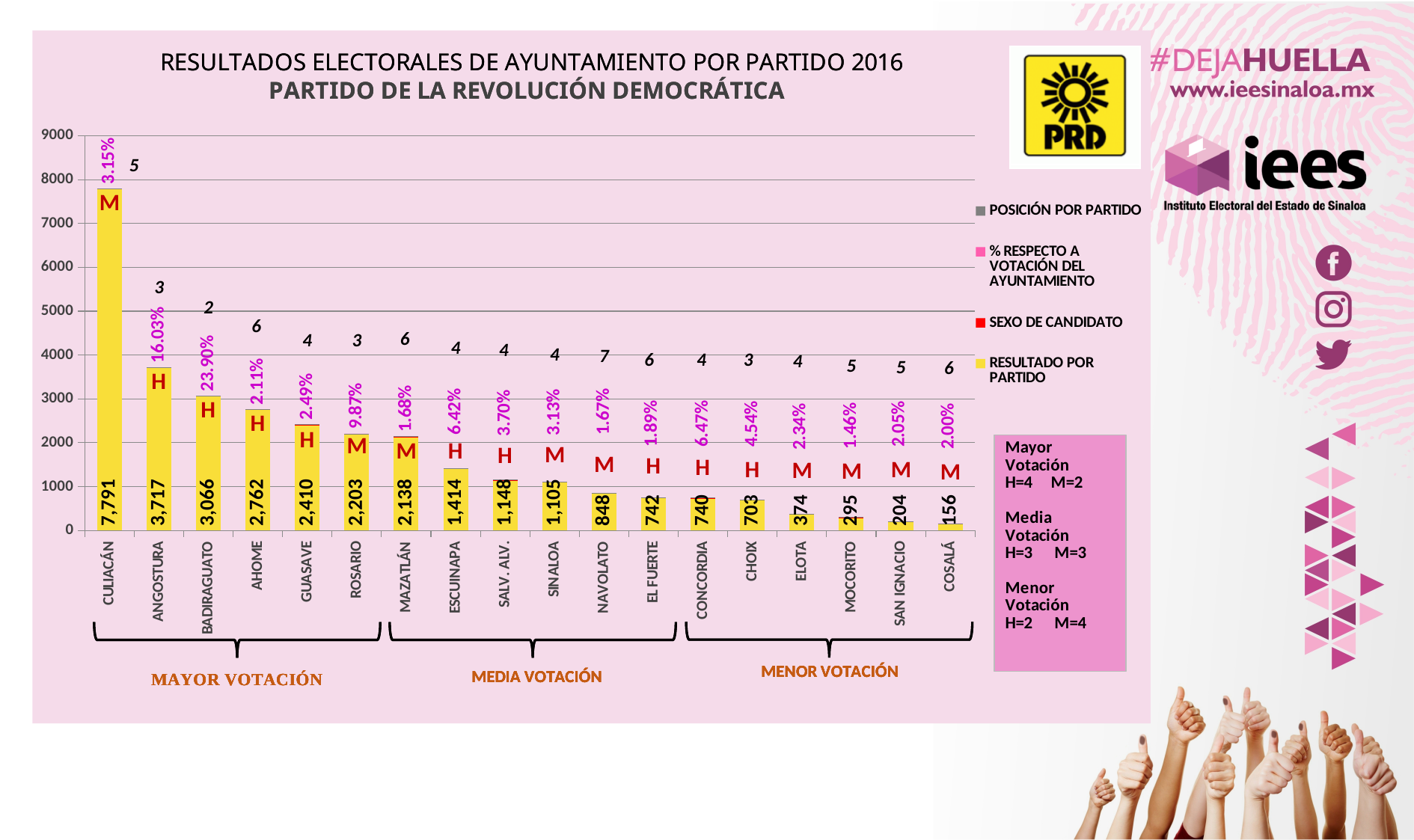
Which has a larger RESULTADO POR PARTIDO, GUASAVE or ESCUINAPA? GUASAVE Is the RESULTADO POR PARTIDO value for AHOME greater or less than 3000? less What is the RESULTADO POR PARTIDO value for CULIACÁN? 7,791 How many municipalities are shown on the x axis of the chart? 18 How many entries does the chart legend list? 4 What is the difference between the RESULTADO POR PARTIDO values for ANGOSTURA and BADIRAGUATO? 651 What POSICIÓN POR PARTIDO number is shown above NAVOLATO? 7 What percentage (% RESPECTO A VOTACIÓN DEL AYUNTAMIENTO) is shown for BADIRAGUATO? 23.90% What is the RESULTADO POR PARTIDO value for MAZATLÁN? 2,138 What kind of chart is shown on the slide? bar chart Which municipality has the lowest RESULTADO POR PARTIDO? COSALÁ Which municipality has the highest RESULTADO POR PARTIDO? CULIACÁN